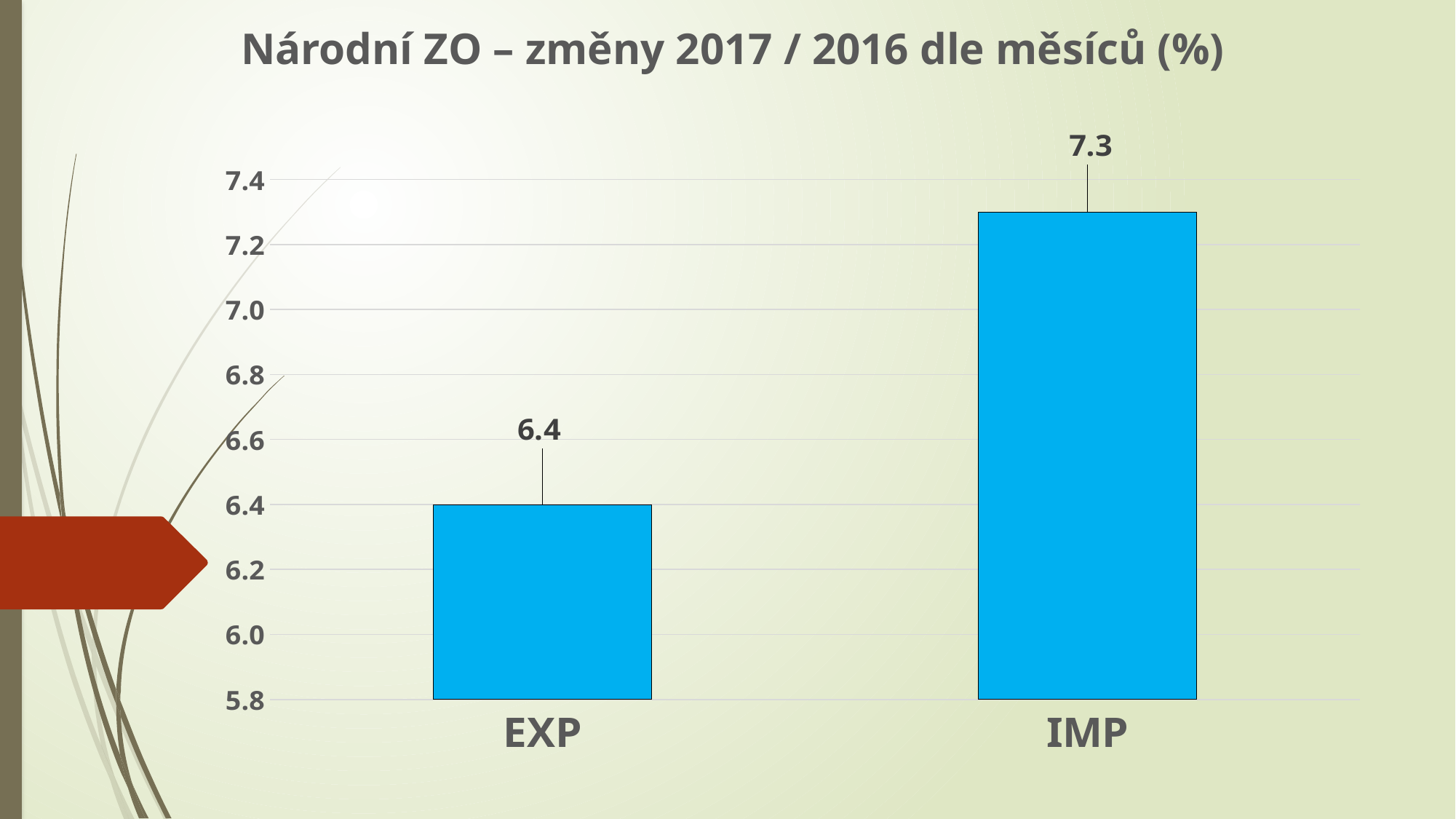
How many categories are shown on the x axis? 2 Which category has the lowest value? EXP What is the value for EXP? 6.4 Is the value for IMP greater or less than 7.0? greater Which category has the highest value? IMP What is the title of the chart? Národní ZO – změny 2017 / 2016 dle měsíců (%) Which is larger, the value for EXP or the value for IMP? IMP What is the value for IMP? 7.3 What colour are the bars in the chart? blue Is the value for EXP greater or less than 7.0? less What kind of chart is shown on the slide? bar chart What is the difference between the values for IMP and EXP? 0.9